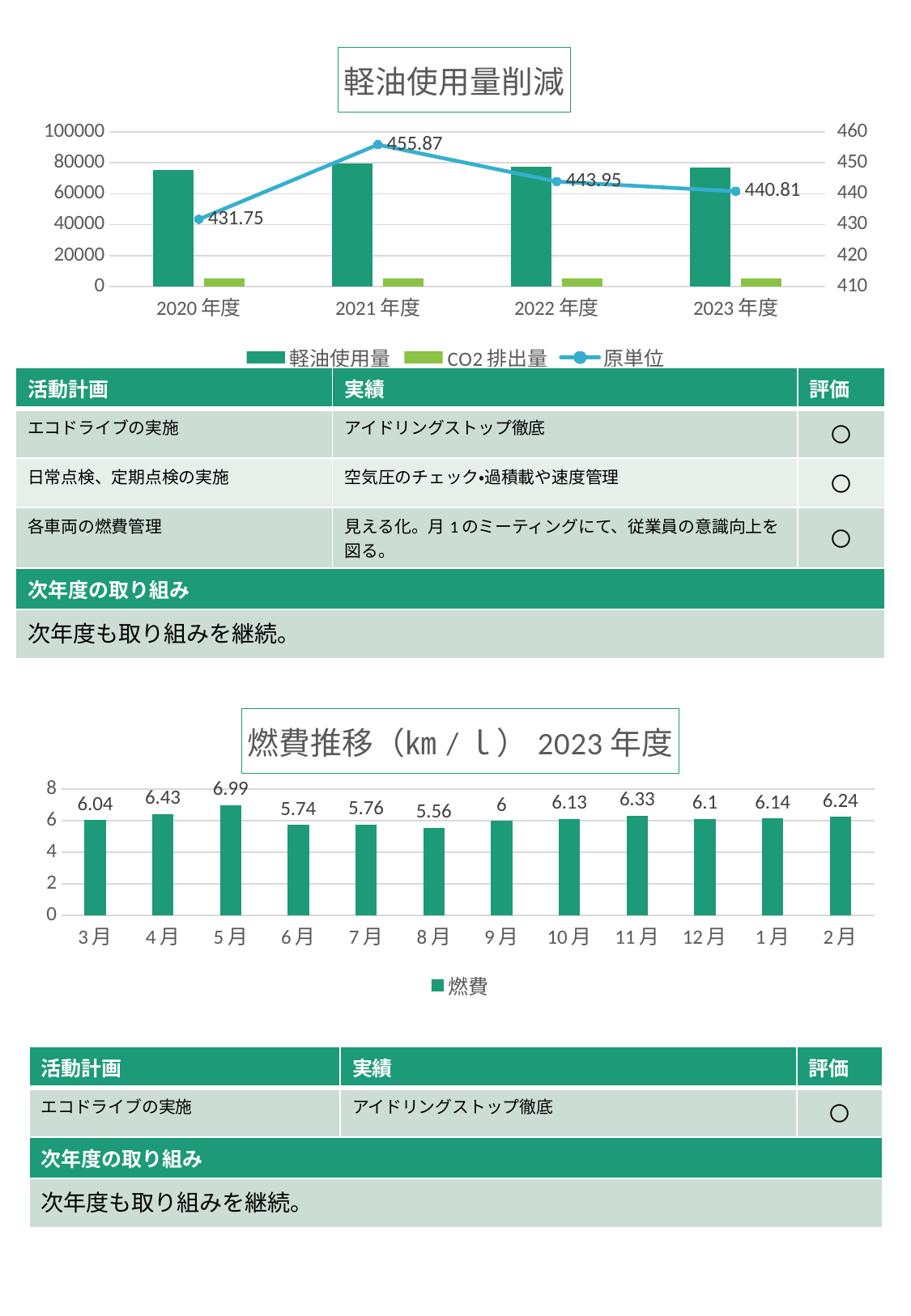
In the 軽油使用量削減 chart, how many series does the legend list? 3 In the 軽油使用量削減 chart, what is the difference between the 原単位 values for 2022年度 and 2023年度? 3.14 In the 軽油使用量削減 chart, is the 軽油使用量 bar for 2021年度 greater or less than 60000? greater In the 軽油使用量削減 chart, which year has the highest 原単位 value? 2021年度 In the 燃費推移（km／ｌ） 2023年度 chart, how many months are plotted? 12 In the 軽油使用量削減 chart, what is the 原単位 value for 2020年度? 431.75 In the 燃費推移（km／ｌ） 2023年度 chart, which is larger, the value for 4月 or the value for 11月? 4月 In the 燃費推移（km／ｌ） 2023年度 chart, what is the 燃費 value for 5月? 6.99 In the 燃費推移（km／ｌ） 2023年度 chart, which month has the lowest 燃費 value? 8月 In the 軽油使用量削減 chart, what is the 原単位 value for 2021年度? 455.87 What kind of chart is the 燃費推移（km／ｌ） 2023年度 chart? bar chart In the 燃費推移（km／ｌ） 2023年度 chart, what is the difference between the values for 5月 and 8月? 1.43